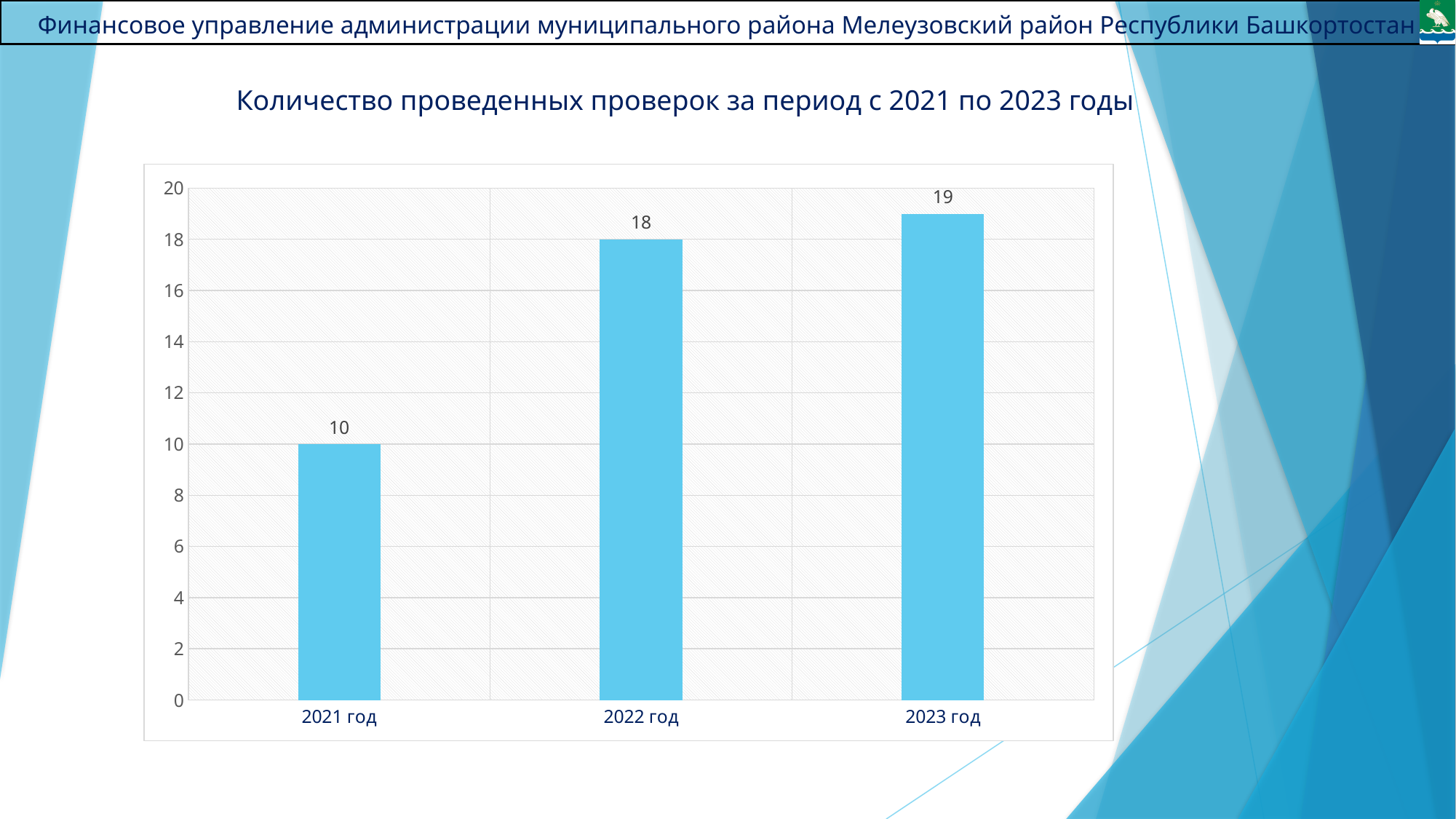
Is the value for 2021 год greater or less than 12? less Do the values rise or fall from 2021 год to 2023 год? rise Which year has the highest number of inspections? 2023 год What is the difference between the values for 2023 год and 2021 год? 9 What is the difference between the values for 2022 год and 2021 год? 8 What kind of chart is shown on the slide? bar chart How many categories are shown on the x axis? 3 What is the value for 2023 год? 19 What is the value for 2022 год? 18 Which is larger, the value for 2021 год or the value for 2022 год? 2022 год Which year has the lowest number of inspections? 2021 год What is the value for 2021 год? 10